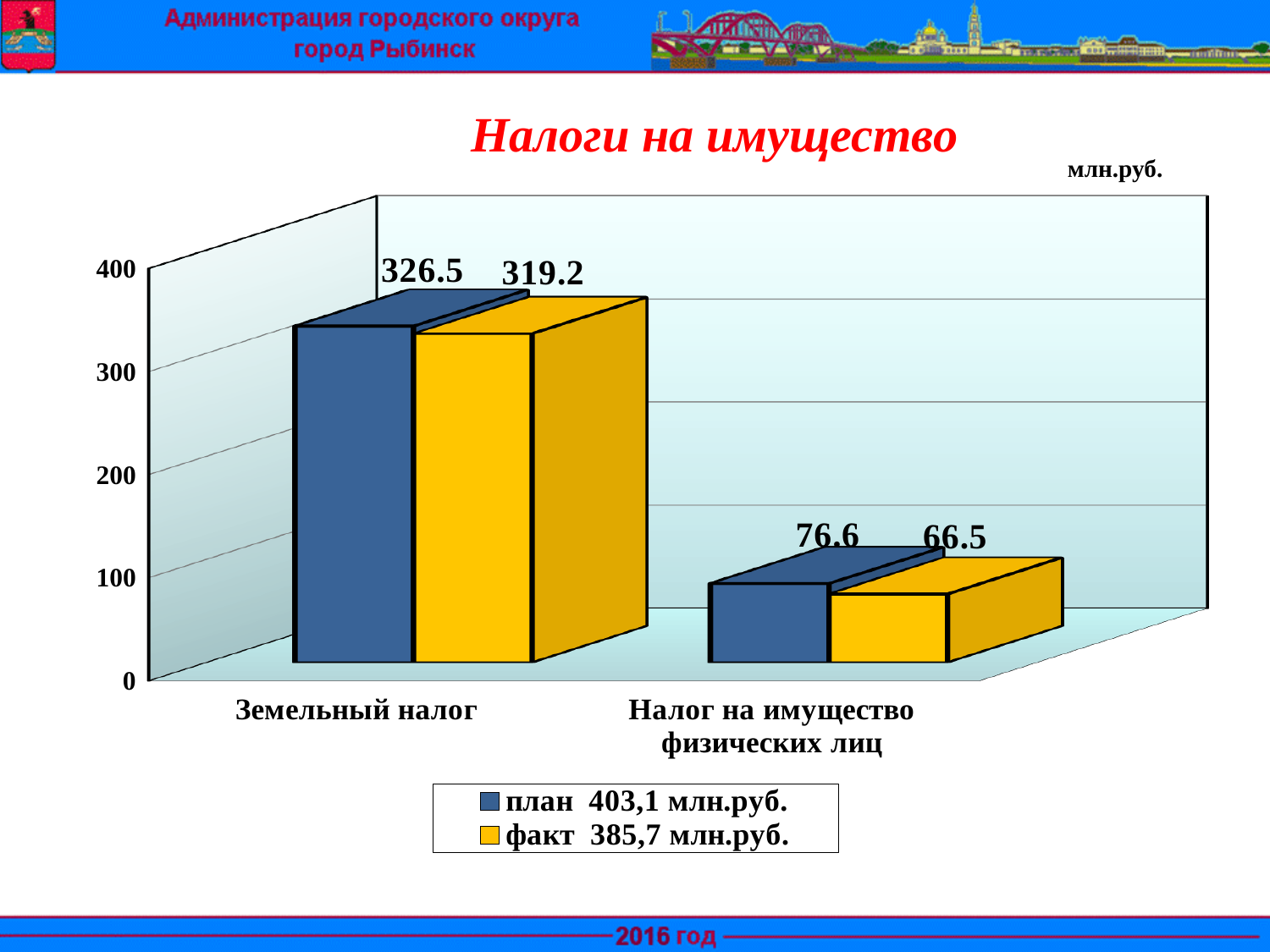
How many series does the legend list? 2 What is the difference between the план and факт values for Налог на имущество физических лиц? 10.1 What is the план value for Налог на имущество физических лиц? 76.6 What is the факт value for Земельный налог? 319.2 What is the факт value for Налог на имущество физических лиц? 66.5 Which is larger for Налог на имущество физических лиц: план or факт? план How many categories are shown on the x axis? 2 Which category has the lowest факт value? Налог на имущество физических лиц Which category has the highest план value? Земельный налог What kind of chart is shown on the slide? bar chart What is the difference between the план and факт values for Земельный налог? 7.3 What is the план value for Земельный налог? 326.5